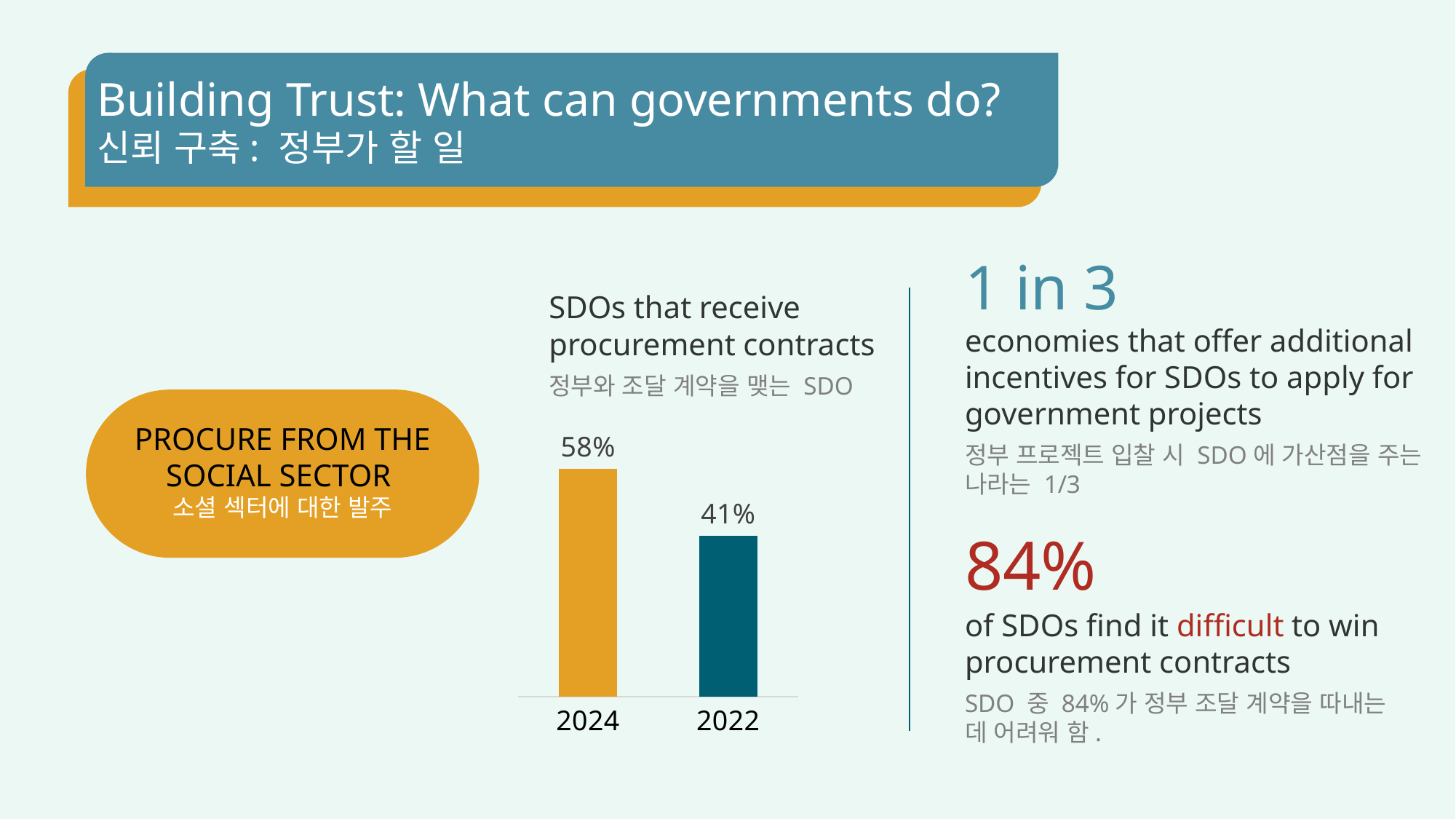
Which years are shown as categories on the chart's x axis? 2024 and 2022 Which year has the higher share of SDOs receiving procurement contracts? 2024 Which year has the lower share of SDOs receiving procurement contracts? 2022 What is the title of the chart? SDOs that receive procurement contracts What colour is the bar for 2024? orange/yellow How many bars are shown in the chart? 2 What is the difference in percentage points between the 2024 and 2022 values? 17 percentage points What percentage of SDOs received procurement contracts in 2022? 41% What percentage of SDOs received procurement contracts in 2024? 58% What type of chart is used to show SDOs that receive procurement contracts? bar chart Is the value for 2024 larger or smaller than the value for 2022? larger